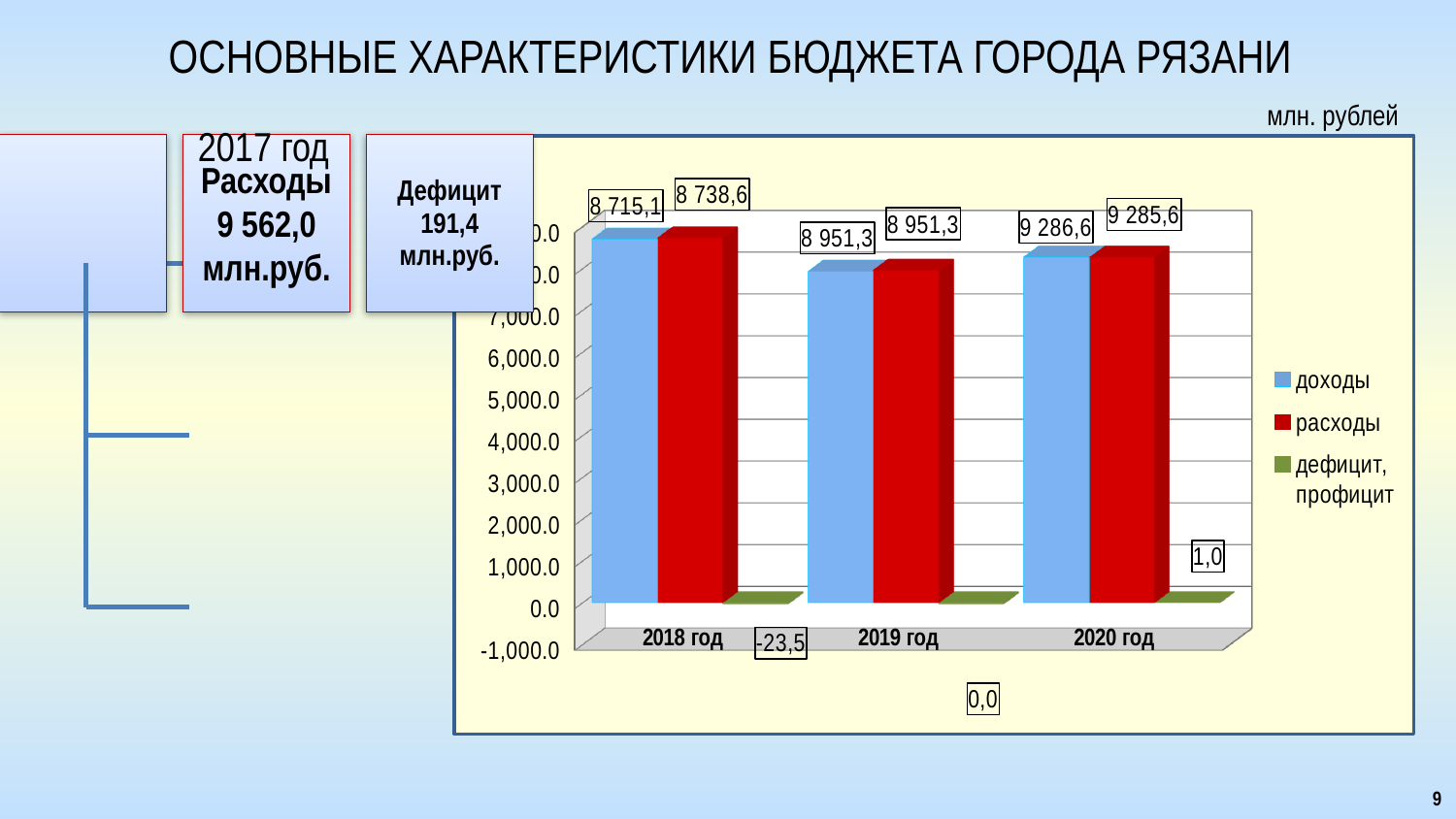
What is the difference between расходы and доходы for 2018 год? 23,5 What is the value of доходы for 2018 год? 8 715,1 Is the value of доходы for 2018 год greater or less than 8,000.0? greater Which year has the highest value of доходы? 2020 год Which is larger: доходы for 2020 год or доходы for 2018 год? доходы for 2020 год Do the values of доходы rise or fall from 2018 год to 2020 год? rise What is the value of доходы for 2019 год? 8 951,3 Which year has the lowest value of расходы? 2018 год How many years are shown on the x axis of the chart? 3 How many series does the chart legend list? 3 What is the value of расходы for 2020 год? 9 285,6 What is the value of дефицит, профицит for 2018 год? -23,5